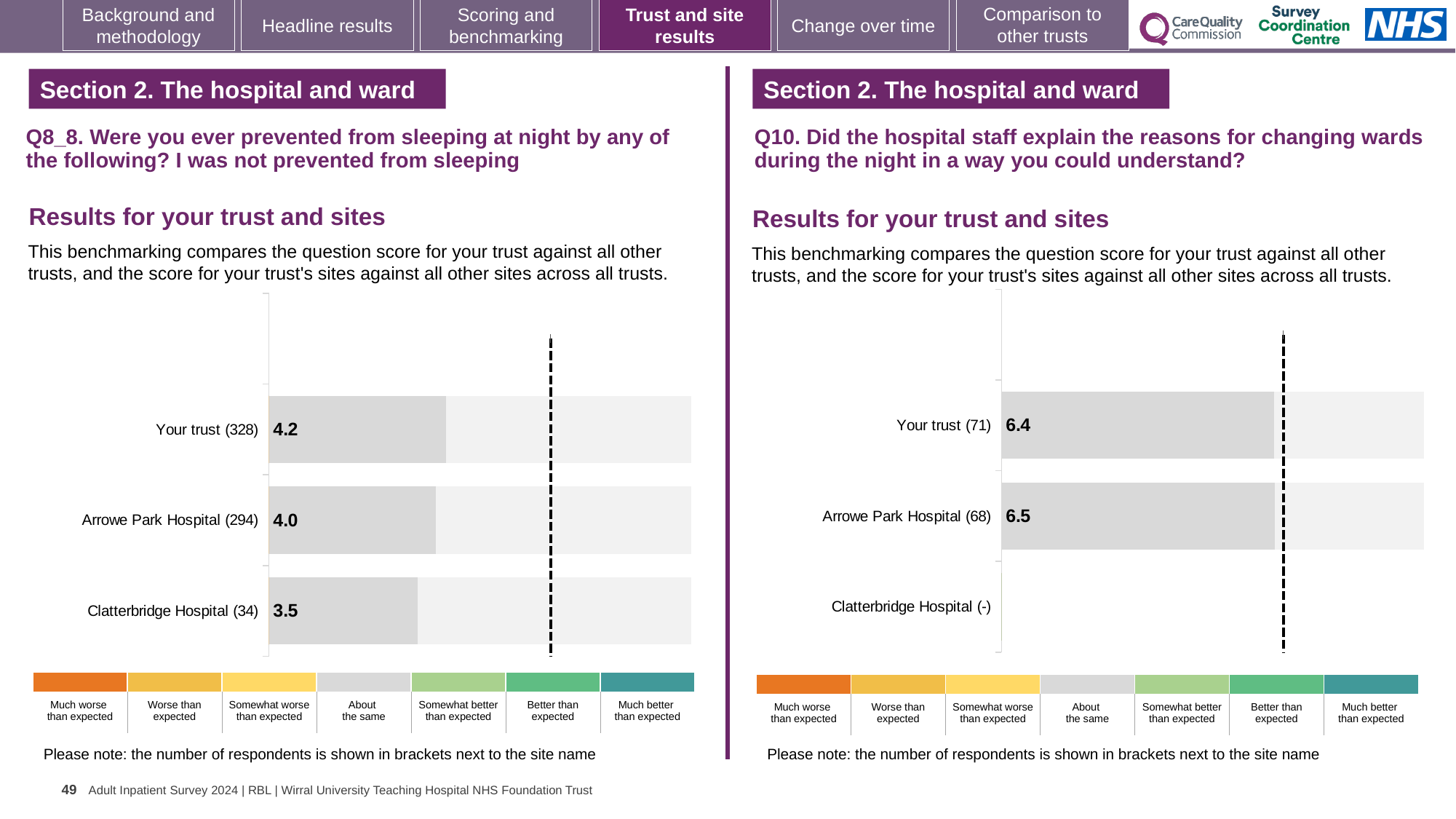
On the Q8_8 chart (left), what is the difference between the scores for Your trust and Clatterbridge Hospital? 0.7 On the Q8_8 chart (left), what is the score for Clatterbridge Hospital? 3.5 On the Q10 chart (right), what is the difference between the scores for Arrowe Park Hospital and Your trust? 0.1 On the Q8_8 chart (left), which site or trust has the lowest score? Clatterbridge Hospital What type of chart is used on the Q8_8 chart (left)? Bar chart On the Q8_8 chart (left), how many respondents are shown for Arrowe Park Hospital? 294 On the Q10 chart (right), which has the higher score, Your trust or Arrowe Park Hospital? Arrowe Park Hospital On the Q10 chart (right), what is the score for Your trust? 6.4 How many bars with a printed score are shown on the Q10 chart (right)? 2 On the Q10 chart (right), how many respondents are shown for Your trust? 71 On the Q10 chart (right), what is the score for Arrowe Park Hospital? 6.5 On the Q8_8 chart (left), what is the score for Your trust? 4.2